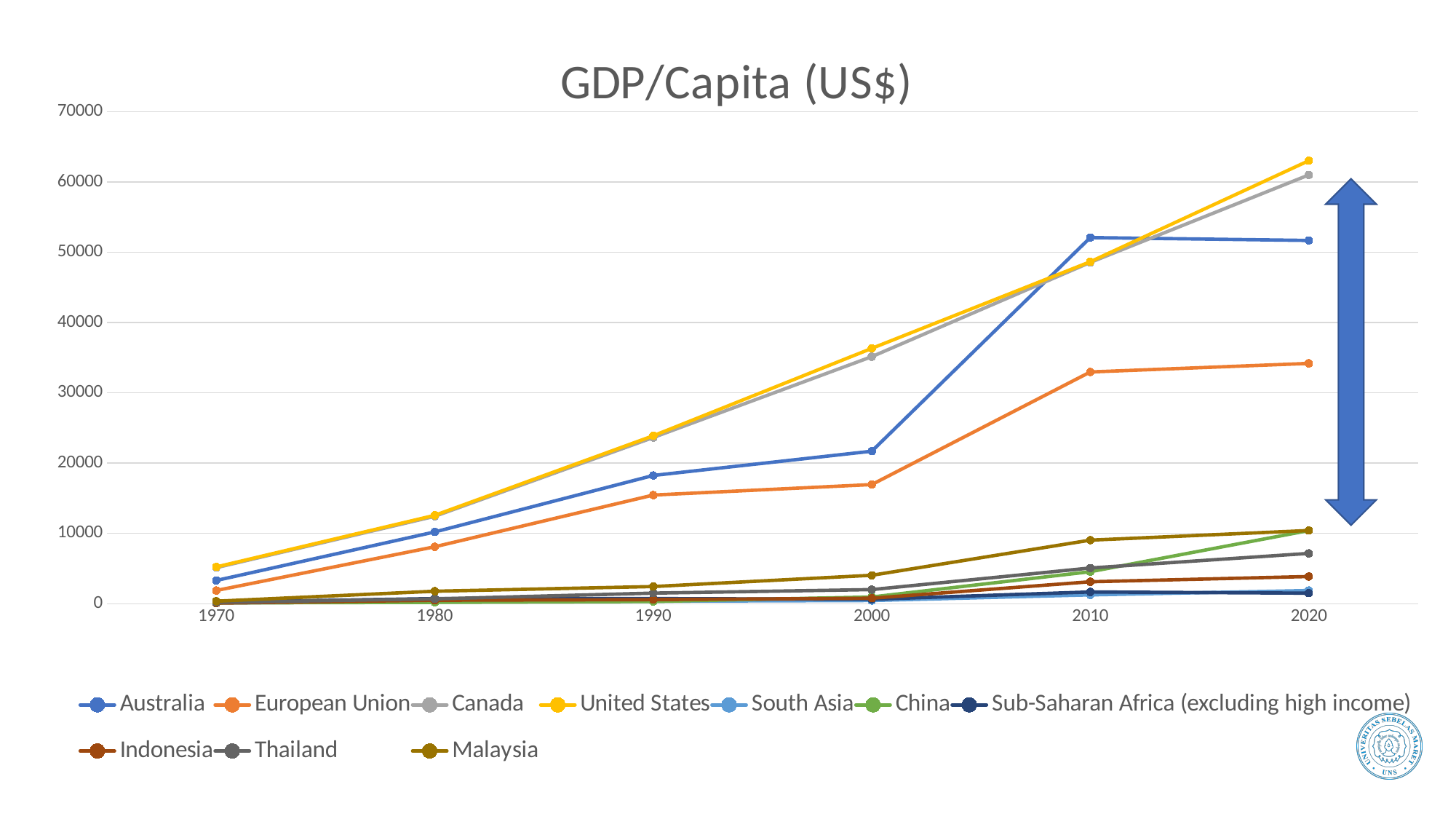
What is the title of the chart? GDP/Capita (US$) Does the European Union line rise or fall from 1970 to 2020? rise What kind of chart is shown on the slide? line chart Which series has the highest GDP per capita in 2020? United States In 2010, which is larger: Australia or European Union? Australia Is the value for Thailand in 2020 greater or less than 10000? less How many series does the legend list? 10 How many years are shown on the x axis? 6 Is the value for United States in 2020 greater or less than 60000? greater Is the value for European Union in 2000 greater or less than 20000? less Which series has the highest GDP per capita in 2010? Australia